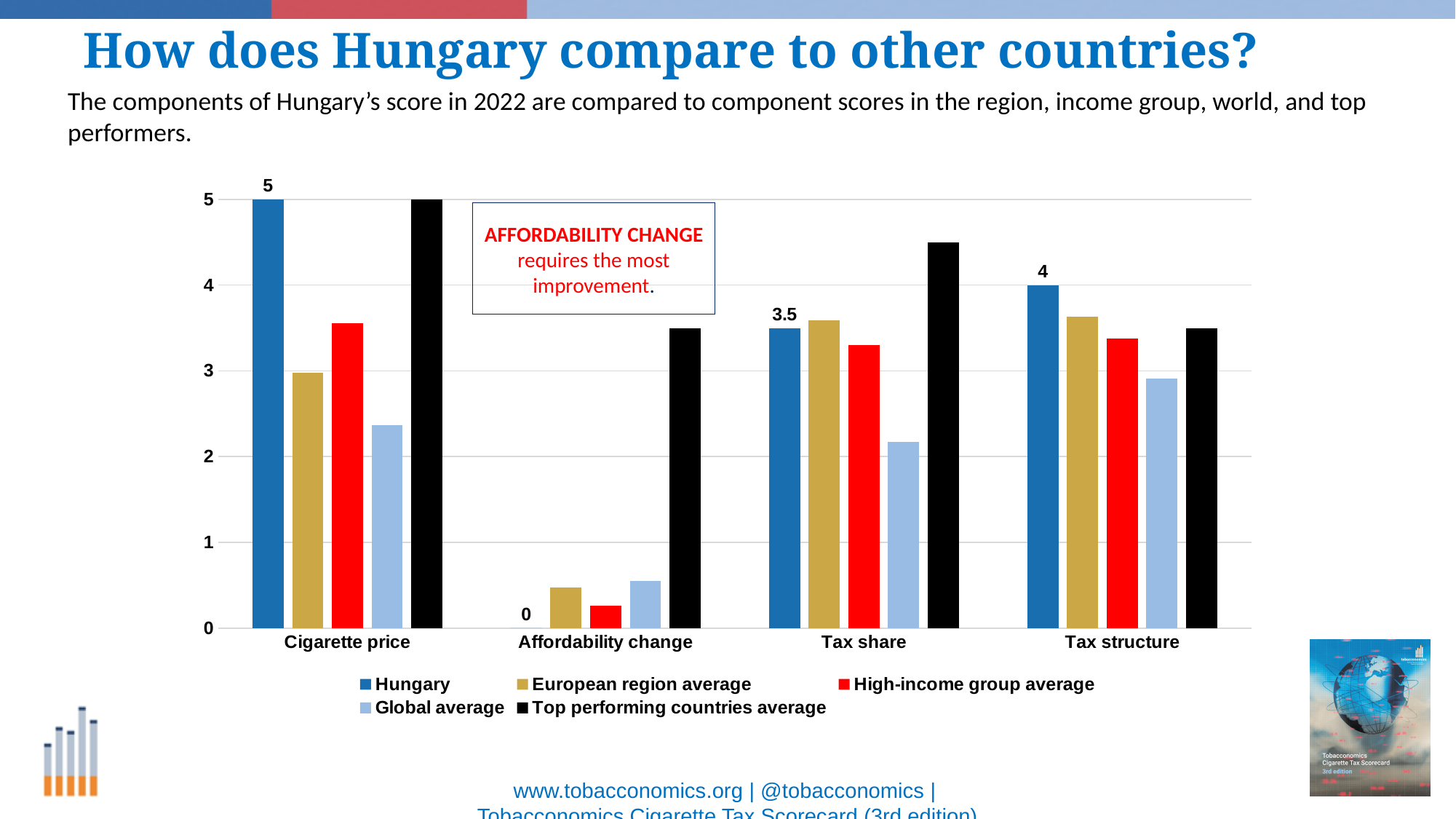
What is Hungary's score for Cigarette price? 5 What is Hungary's score for Tax structure? 4 How many components are shown on the x axis? 4 Which series is shown in black in the legend? Top performing countries average How many series does the legend list? 5 On which component does Hungary have its lowest score? Affordability change What kind of chart is shown on the slide? bar chart On which component does Hungary have its highest score? Cigarette price What is Hungary's score for Affordability change? 0 What is the difference between Hungary's Cigarette price score and its Tax share score? 1.5 Is the Global average value for Cigarette price greater or less than 3? less What is Hungary's score for Tax share? 3.5